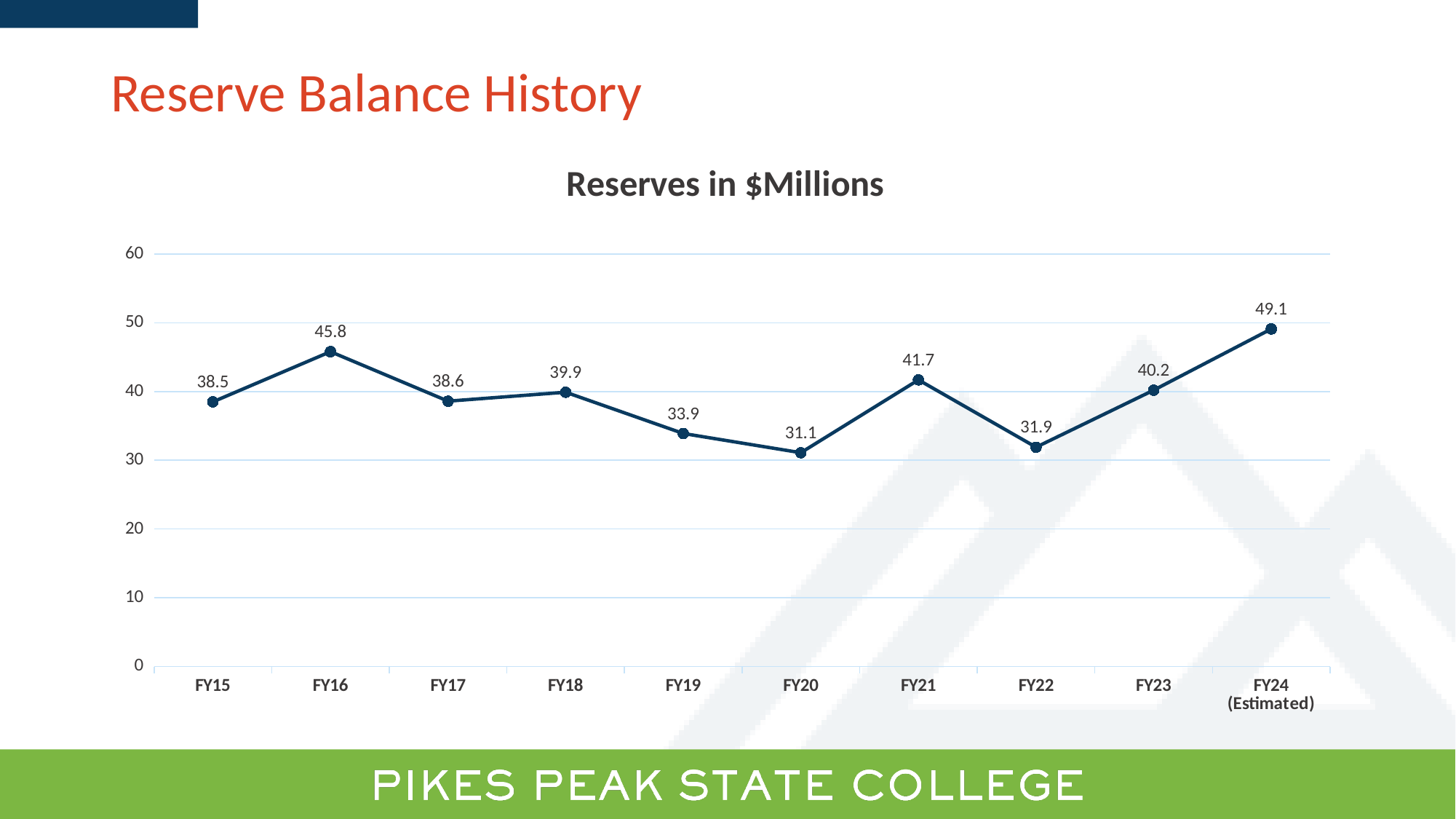
Which fiscal year has the highest reserve value? FY24 (Estimated) What kind of chart is shown on the slide? line chart How many fiscal years are plotted on the chart? 10 What is the value for FY16? 45.8 What is the value for FY20? 31.1 Do the values rise or fall from FY22 to FY24 (Estimated)? rise What is the difference between the values for FY21 and FY22? 9.8 Which fiscal year has the lowest reserve value? FY20 Is the value for FY19 greater or less than 40? less What is the value for FY24 (Estimated)? 49.1 Which is larger, the value for FY15 or the value for FY18? FY18 What is the title of the chart? Reserves in $Millions